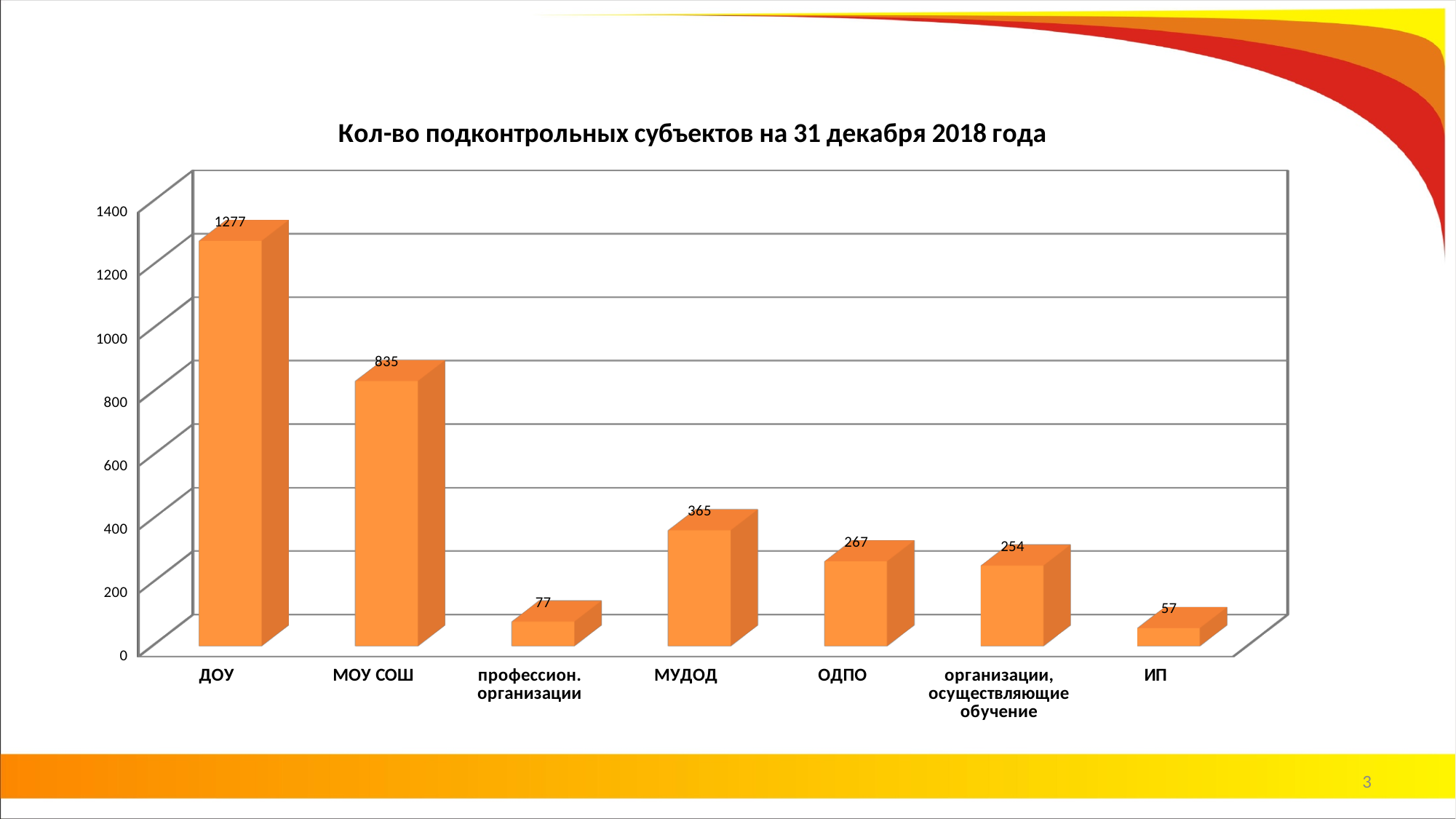
What is the value for МУДОД? 365 What is the title of the chart? Кол-во подконтрольных субъектов на 31 декабря 2018 года Which category has the lowest value? ИП What kind of chart is shown on the slide? bar chart What is the value for ИП? 57 What is the value for МОУ СОШ? 835 What is the value for ДОУ? 1277 Which is larger, the value for ОДПО or the value for организации, осуществляющие обучение? ОДПО What is the difference between the values for ДОУ and МОУ СОШ? 442 Is the value for профессион. организации greater or less than 200? less How many categories are shown on the x axis? 7 Which category has the highest value? ДОУ